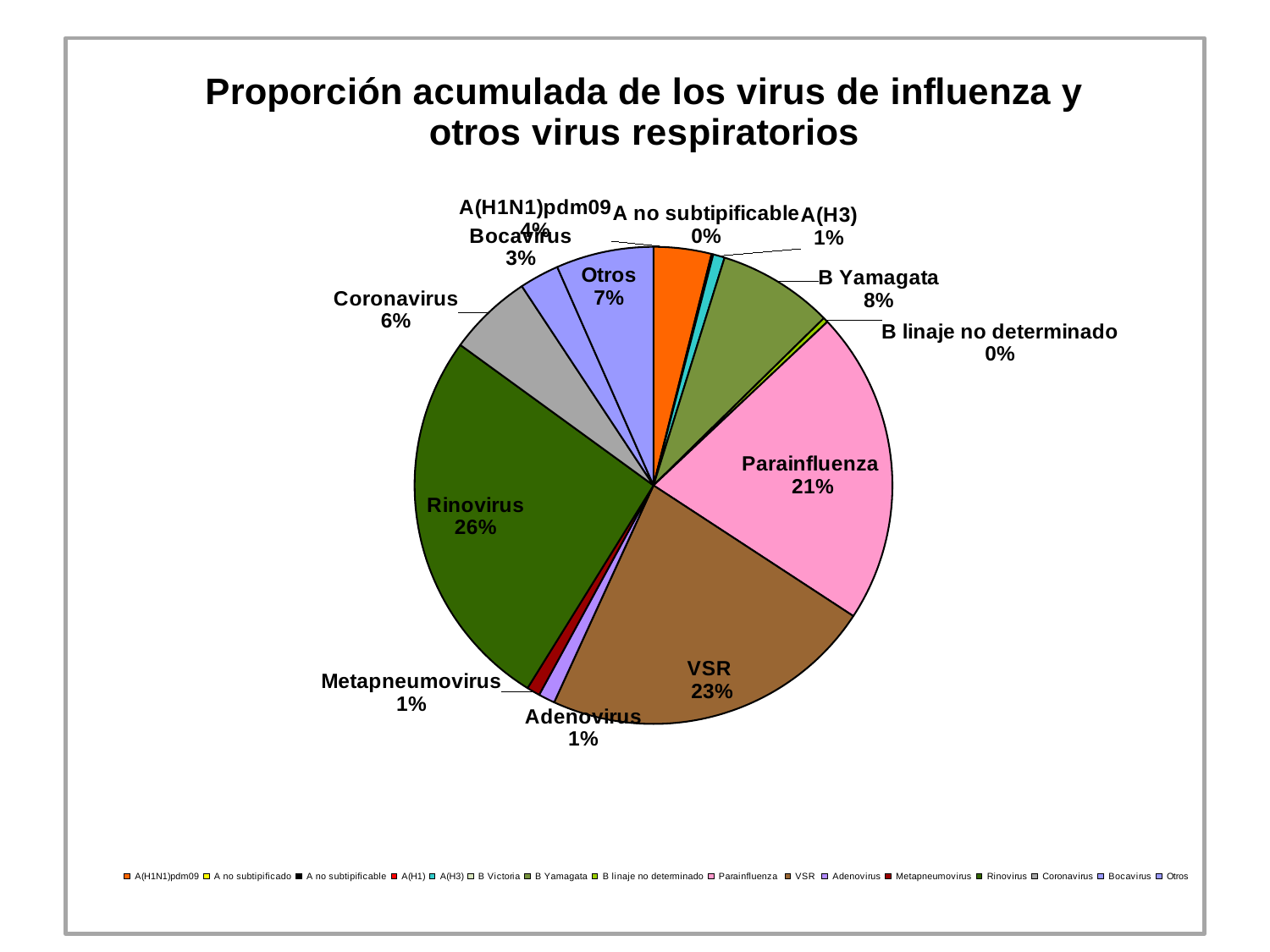
What share of the pie does Rinovirus represent? 26% What is the difference between the shares of VSR and Parainfluenza? 2% What is the value shown for Parainfluenza? 21% What type of chart is shown on the slide? pie chart What is the value shown for VSR? 23% What is the difference between the shares of Rinovirus and B Yamagata? 18% Which is larger, the share for Otros or the share for Coronavirus? Otros Which category has the largest slice of the pie? Rinovirus How many entries does the legend list? 16 What is the title of the chart? Proporción acumulada de los virus de influenza y otros virus respiratorios What is the value shown for B Yamagata? 8% What is the value shown for Coronavirus? 6%